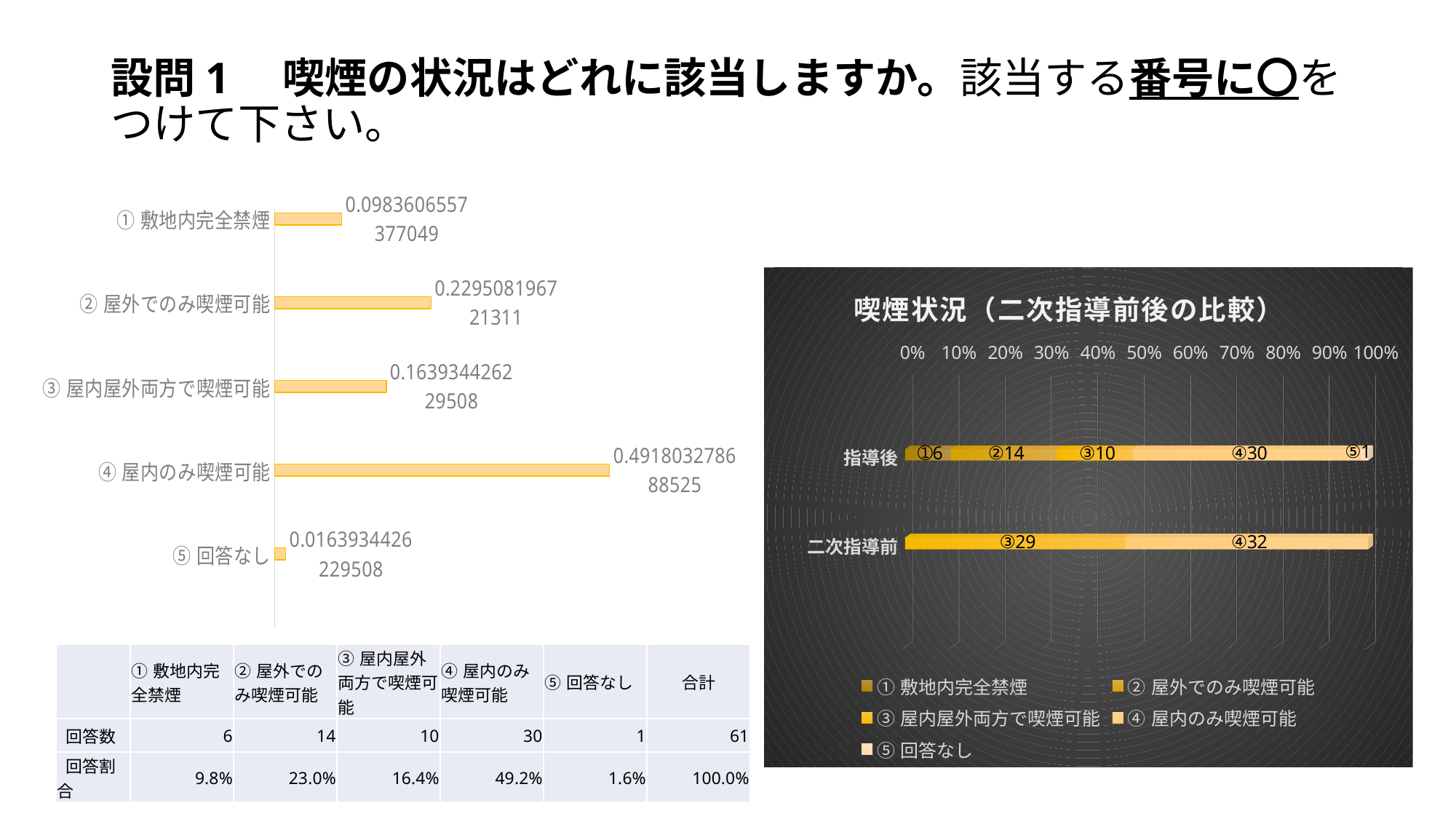
In the left chart, which is larger: ② 屋外でのみ喫煙可能 or ③ 屋内屋外両方で喫煙可能? ② 屋外でのみ喫煙可能 How many series does the legend of the chart titled 喫煙状況（二次指導前後の比較） list? 5 What kind of chart is the left chart? bar chart In the chart titled 喫煙状況（二次指導前後の比較）, what is the total of the 指導後 bar? 61 In the chart titled 喫煙状況（二次指導前後の比較）, what is the value of ④ for 指導後? 30 In the left chart, which category has the longest bar? ④ 屋内のみ喫煙可能 In the chart titled 喫煙状況（二次指導前後の比較）, what is the value of ③ for 二次指導前? 29 In the chart titled 喫煙状況（二次指導前後の比較）, what is the difference between ④ for 二次指導前 and ④ for 指導後? 2 In the left chart, which category has the shortest bar? ⑤ 回答なし In the left chart, what is the data label for ④ 屋内のみ喫煙可能? 0.491803278688525 How many categories are shown in the left chart? 5 In the left chart, what is the data label for ① 敷地内完全禁煙? 0.0983606557377049